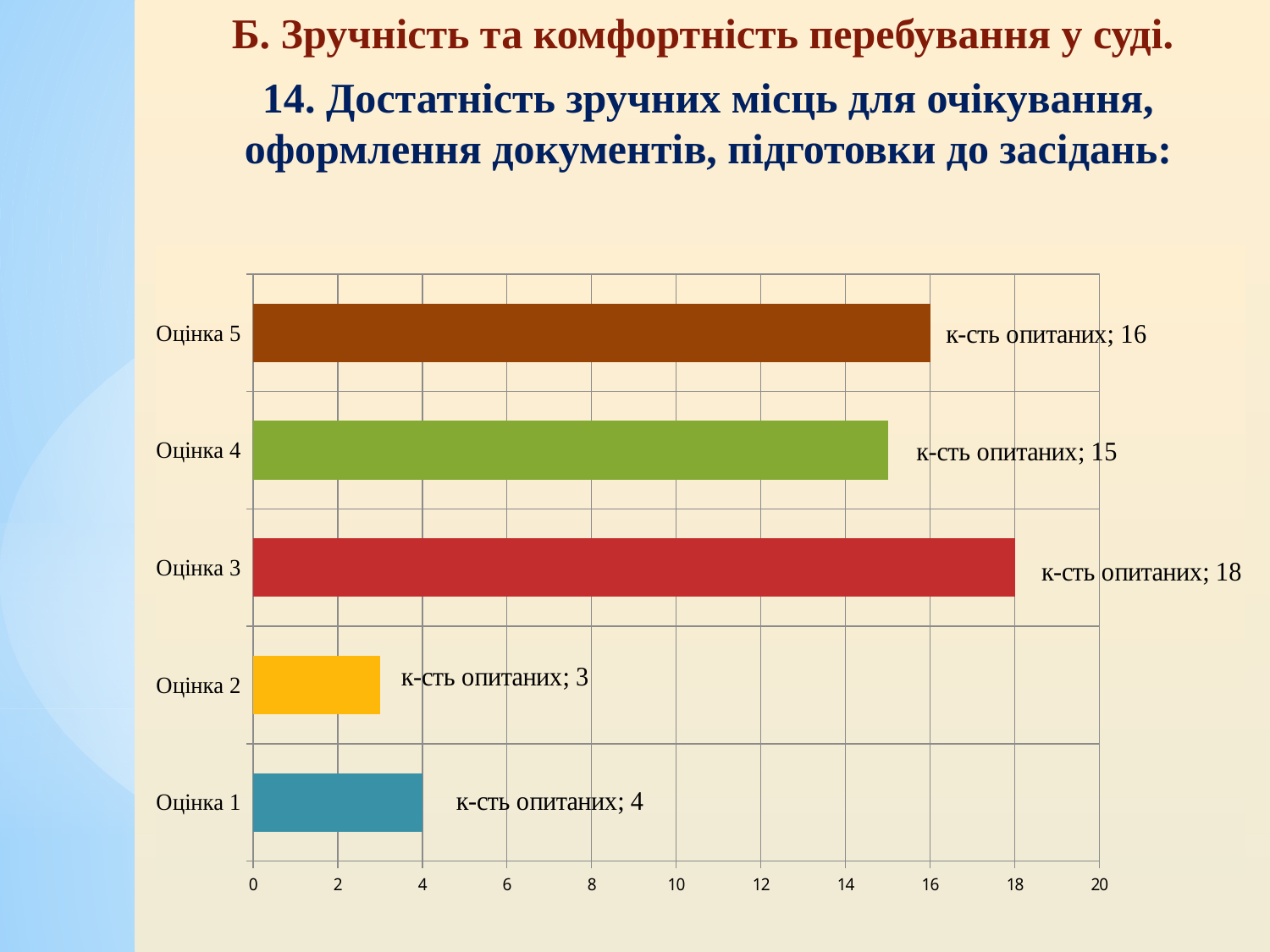
What is the value for Оцінка 5? 16 What is the difference between the values for Оцінка 3 and Оцінка 4? 3 What is the value for Оцінка 2? 3 What is the name of the data series shown in the data labels? к-сть опитаних Which is larger, the value for Оцінка 5 or the value for Оцінка 4? Оцінка 5 How many categories are shown in the chart? 5 What is the value for Оцінка 1? 4 Is the value for Оцінка 3 greater or less than 10? greater What kind of chart is shown on the slide? bar chart What is the total of all the values shown in the chart? 56 Which category has the highest value? Оцінка 3 Which category has the lowest value? Оцінка 2